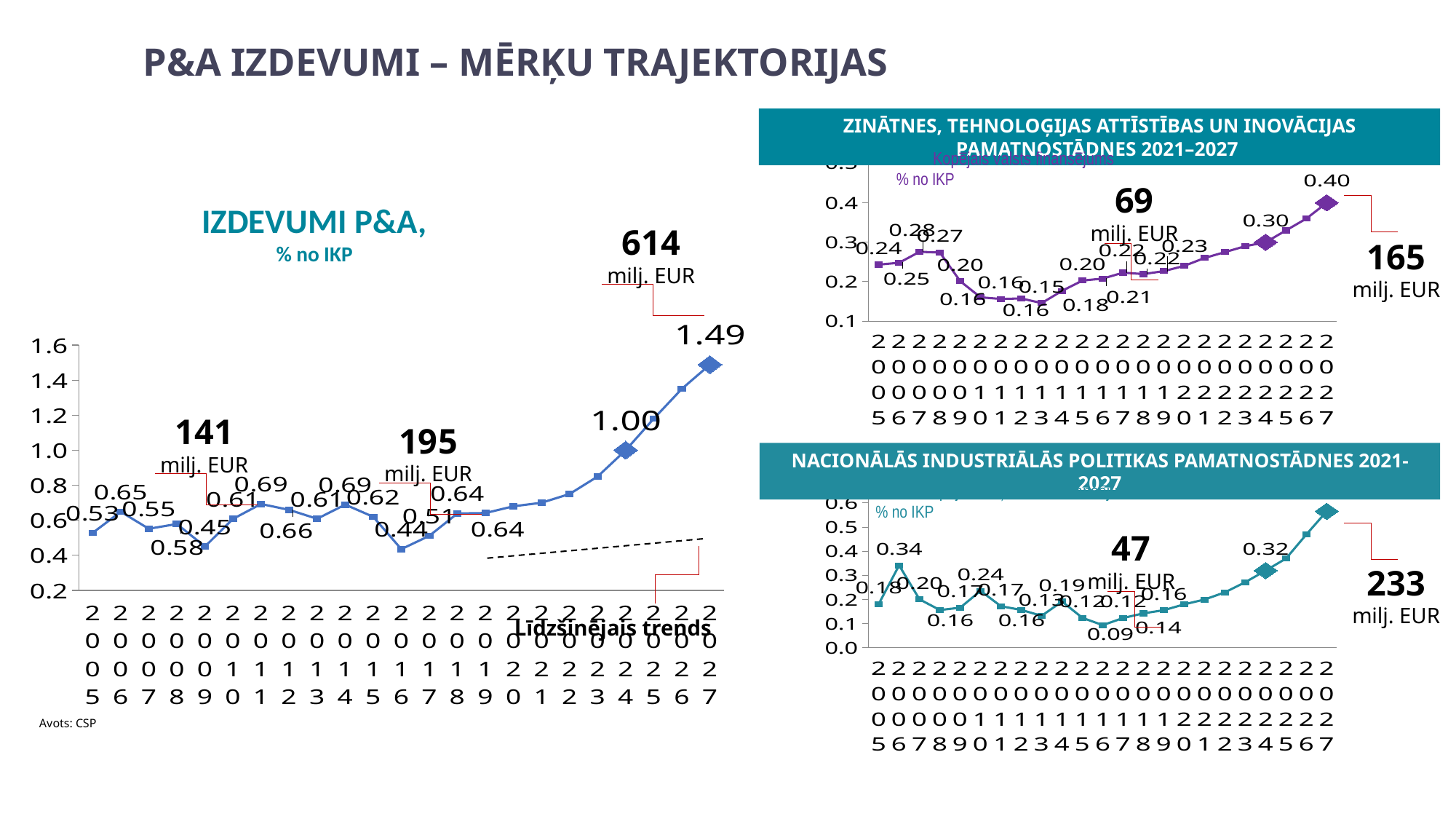
On the chart titled 'IZDEVUMI P&A, % no IKP', what is the difference between the 2027 and 2024 values? 0.49 On the bottom-right chart (NACIONĀLĀS INDUSTRIĀLĀS POLITIKAS PAMATNOSTĀDNES 2021-2027), is the value for 2027 greater or less than 0.5? greater What kind of chart is the chart titled 'IZDEVUMI P&A, % no IKP'? line chart On the top-right chart (ZINĀTNES, TEHNOLOĢIJAS ATTĪSTĪBAS UN INOVĀCIJAS PAMATNOSTĀDNES 2021–2027), what is the difference between the 2027 and 2024 values? 0.10 On the bottom-right chart (NACIONĀLĀS INDUSTRIĀLĀS POLITIKAS PAMATNOSTĀDNES 2021-2027), which year has the lowest value? 2016 On the chart titled 'IZDEVUMI P&A, % no IKP', what is the value for 2027? 1.49 On the chart titled 'IZDEVUMI P&A, % no IKP', what is the value for 2024? 1.00 On the bottom-right chart (NACIONĀLĀS INDUSTRIĀLĀS POLITIKAS PAMATNOSTĀDNES 2021-2027), what is the value for 2006? 0.34 On the top-right chart (ZINĀTNES, TEHNOLOĢIJAS ATTĪSTĪBAS UN INOVĀCIJAS PAMATNOSTĀDNES 2021–2027), which is larger, the value for 2007 or the value for 2013? 2007 On the chart titled 'IZDEVUMI P&A, % no IKP', do the values rise or fall from 2019 to 2027? rise On the chart titled 'IZDEVUMI P&A, % no IKP', what is the value for 2009? 0.45 On the top-right chart (ZINĀTNES, TEHNOLOĢIJAS ATTĪSTĪBAS UN INOVĀCIJAS PAMATNOSTĀDNES 2021–2027), what is the value for 2027? 0.40